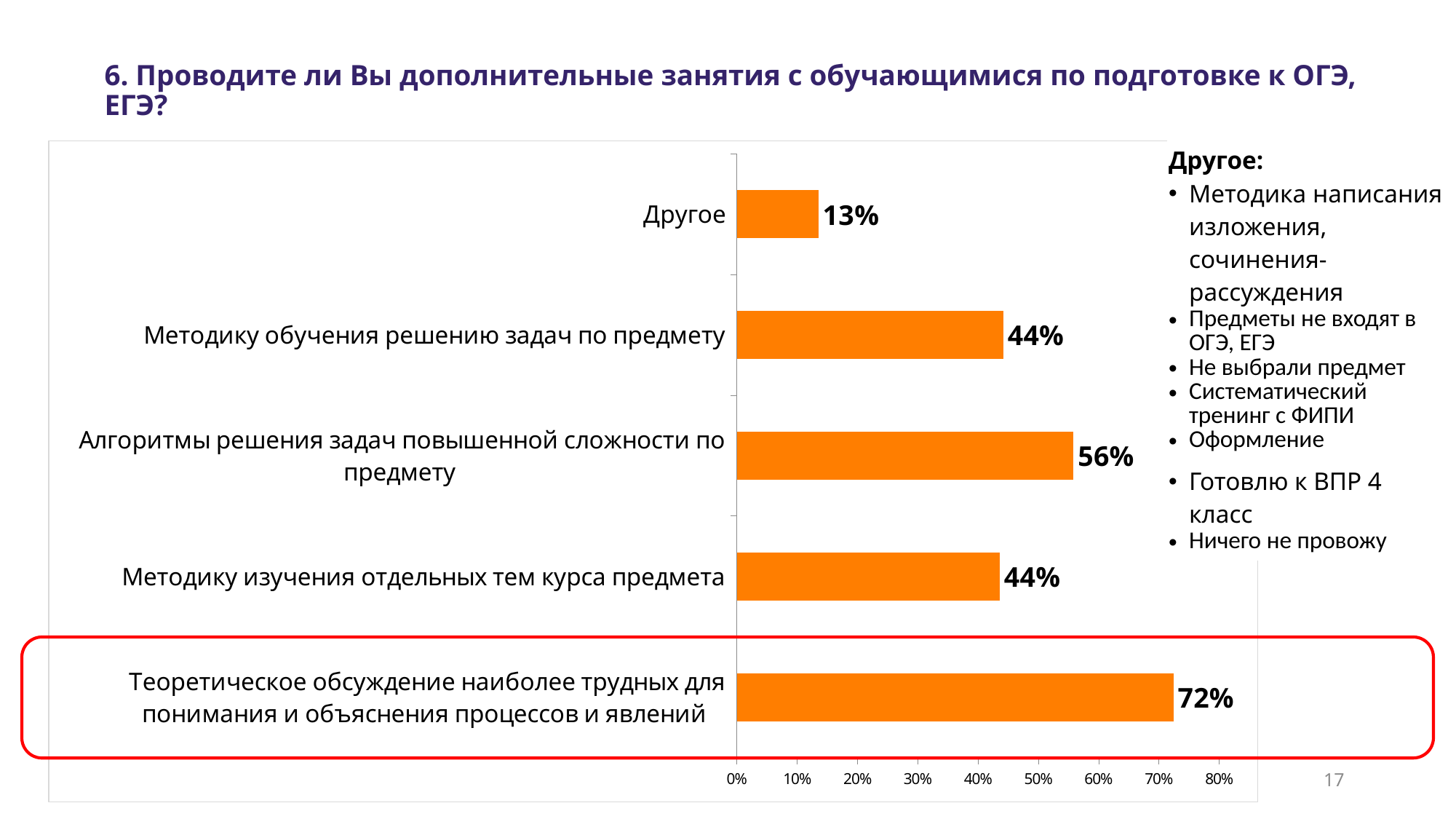
Which category has the highest value? Теоретическое обсуждение наиболее трудных для понимания и объяснения процессов и явлений What is the difference between the values for "Методику обучения решению задач по предмету" and "Другое"? 31% What is the value for "Другое"? 13% What is the difference between the values for "Теоретическое обсуждение наиболее трудных для понимания и объяснения процессов и явлений" and "Алгоритмы решения задач повышенной сложности по предмету"? 16% How many categories are shown in the chart? 5 What is the value for "Алгоритмы решения задач повышенной сложности по предмету"? 56% What is the value for "Теоретическое обсуждение наиболее трудных для понимания и объяснения процессов и явлений"? 72% What is the value for "Методику изучения отдельных тем курса предмета"? 44% What kind of chart is shown on the slide? Bar chart Is the value for "Другое" greater or less than 20%? less Which category has the lowest value? Другое Which is larger: the value for "Алгоритмы решения задач повышенной сложности по предмету" or the value for "Методику изучения отдельных тем курса предмета"? Алгоритмы решения задач повышенной сложности по предмету